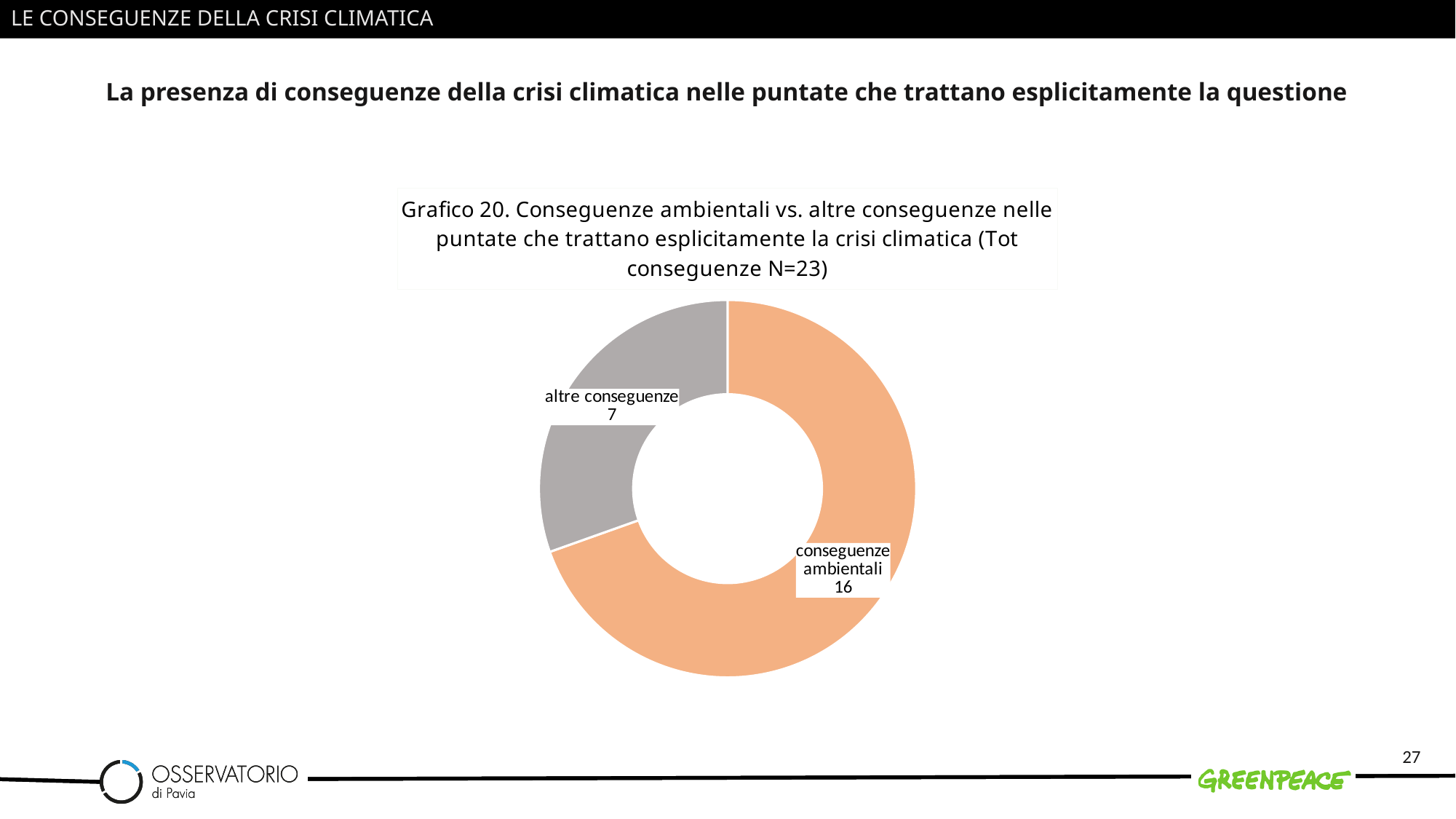
What is the difference between the values for 'conseguenze ambientali' and 'altre conseguenze'? 9 What value is shown for 'conseguenze ambientali'? 16 Which category has the smallest slice? altre conseguenze What kind of chart is shown on the slide? Doughnut (pie) chart What is the total number of consequences (N) stated in the chart title? 23 What colour is the slice for 'conseguenze ambientali'? Orange What is the total of the two values shown in the chart? 23 What value is shown for 'altre conseguenze'? 7 How many categories are shown in the chart? 2 Which is larger, 'conseguenze ambientali' or 'altre conseguenze'? conseguenze ambientali Which category has the largest slice? conseguenze ambientali